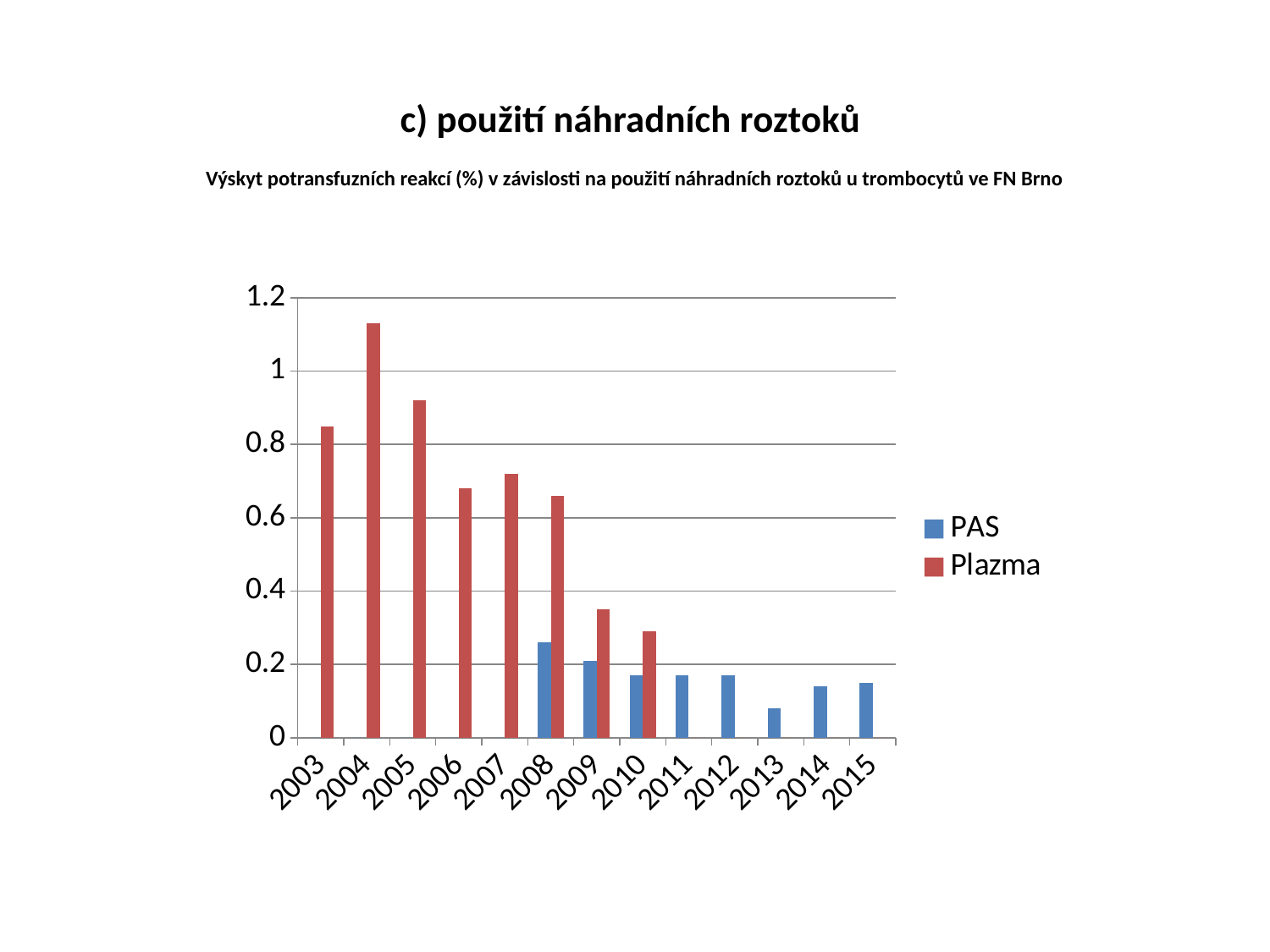
What kind of chart is shown on the slide? bar chart Is the Plazma value for 2003 greater or less than 0.8? greater How many years are shown on the x axis? 13 How many series does the legend list? 2 In which year is the PAS value lowest? 2013 In which year is the Plazma value highest? 2004 Is the Plazma value for 2004 greater or less than 1? greater In 2008, which series has the larger value, PAS or Plazma? Plazma Is the Plazma value for 2009 greater or less than 0.4? less Which year has the larger Plazma value, 2005 or 2006? 2005 Do the Plazma values generally rise or fall from 2004 to 2010? fall